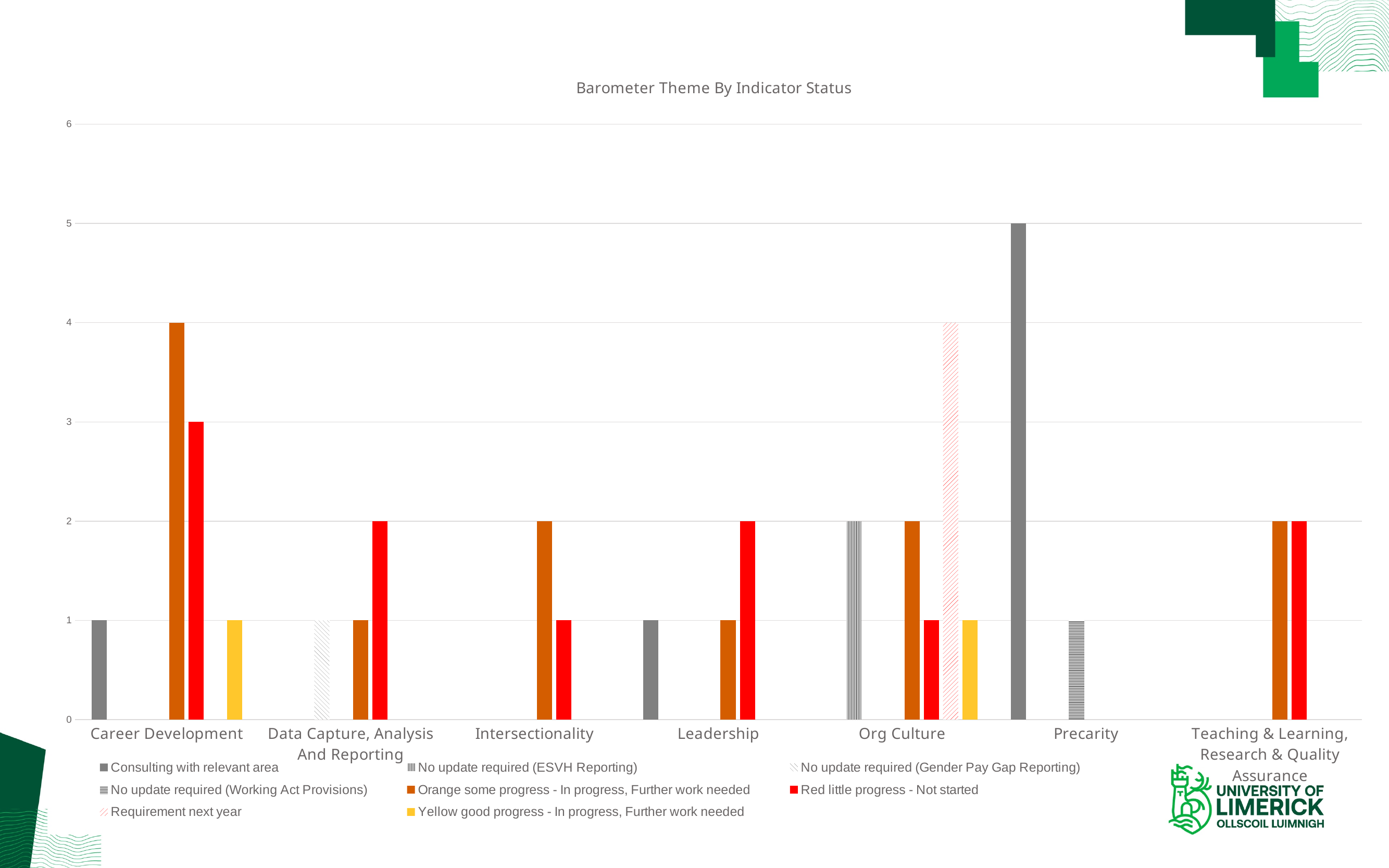
What is the value of 'Consulting with relevant area' for Precarity? 5 What kind of chart is shown on the slide? bar chart What is the title of the chart? Barometer Theme By Indicator Status How many categories are shown on the x axis? 7 Is the value of 'Consulting with relevant area' for Precarity greater or less than 3? greater What is the value of 'Red little progress - Not started' for Leadership? 2 What is the value of 'Requirement next year' for Org Culture? 4 Which category has the tallest bar in the chart? Precarity Which is larger for Intersectionality: 'Orange some progress - In progress, Further work needed' or 'Red little progress - Not started'? Orange some progress - In progress, Further work needed What is the difference between the 'Orange some progress' and 'Red little progress' values for Career Development? 1 What is the value of 'Orange some progress - In progress, Further work needed' for Career Development? 4 How many series does the legend list? 8